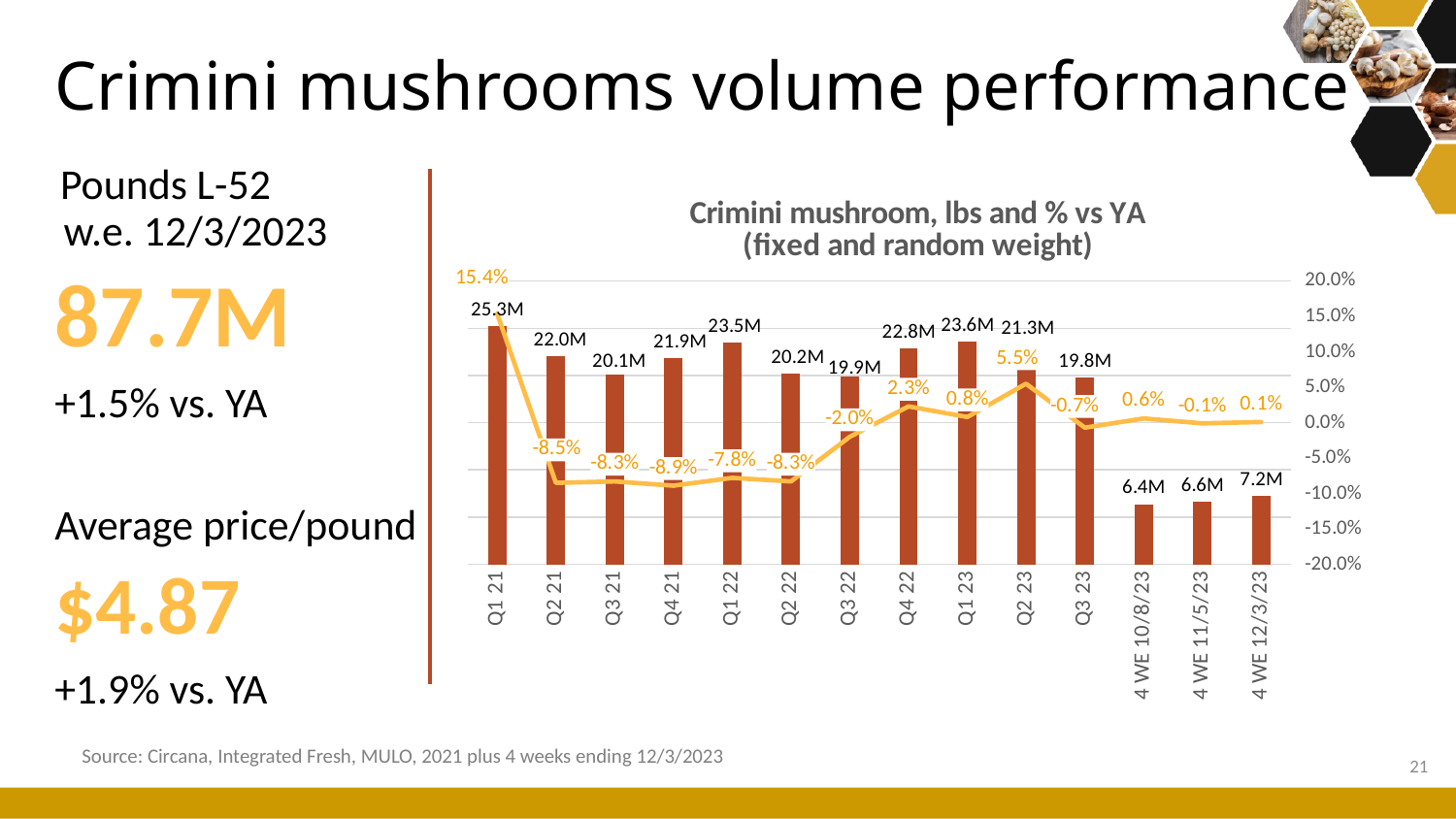
Do the volumes for the three 4 WE periods rise or fall from 10/8/23 to 12/3/23? Rise What kind of chart is this? Combination bar and line chart What is the % vs YA value for Q4 21? -8.9% Which period has the lowest % vs YA value on the line? Q4 21 What is the % vs YA value for Q2 23? 5.5% How many periods are shown on the x axis? 14 Which period has the highest bar (volume in pounds)? Q1 21 What volume in pounds is shown for Q1 21? 25.3M What is the title of the chart? Crimini mushroom, lbs and % vs YA (fixed and random weight) What volume is shown for the 4 WE 12/3/23 period? 7.2M What is the difference in volume between Q1 23 and Q3 23? 3.8M Which has the larger volume, Q4 22 or Q2 23? Q4 22